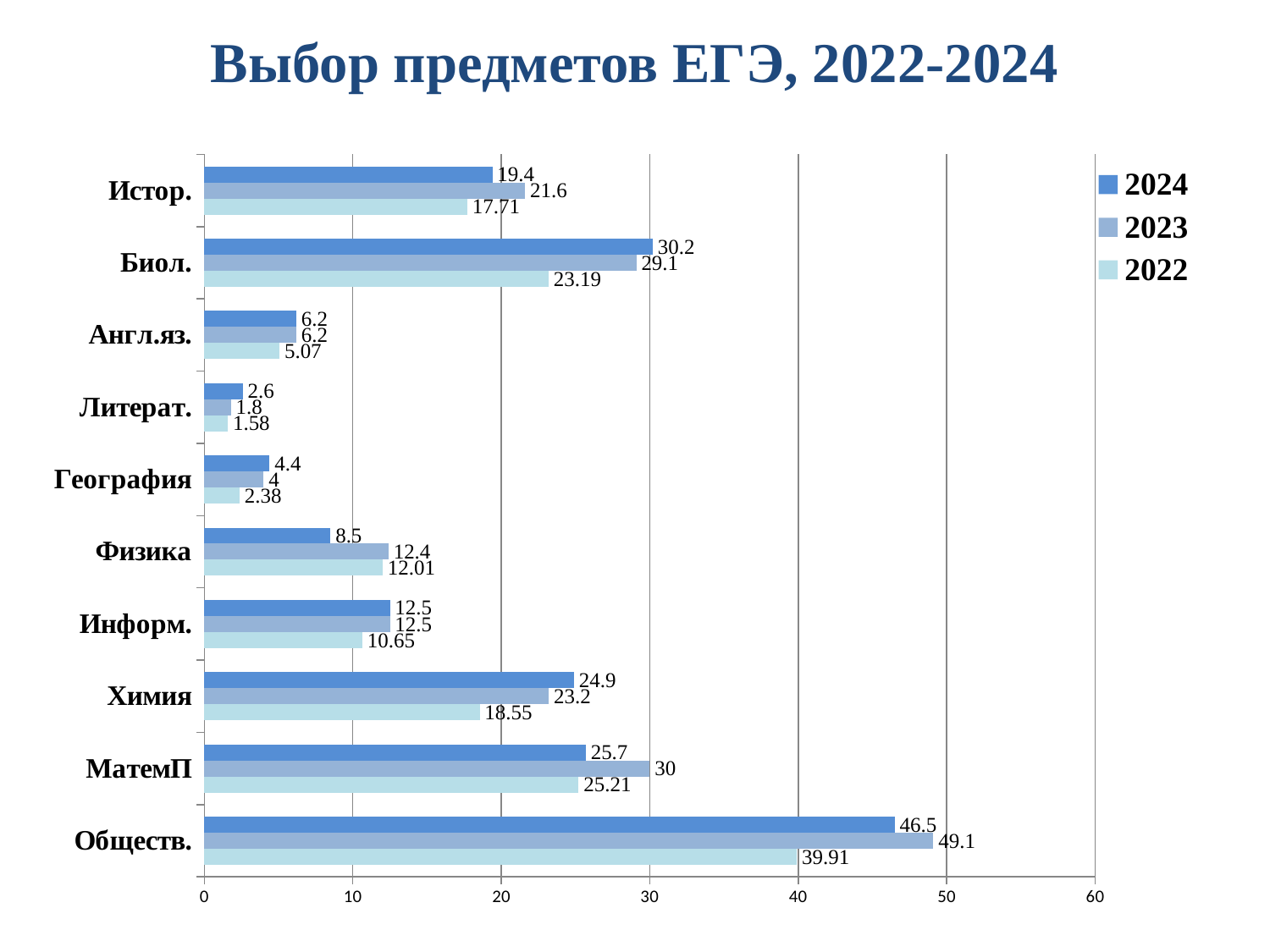
What is the value for МатемП in 2023? 30 Which is larger for Физика: the 2024 value or the 2023 value? 2023 What is the title of the chart? Выбор предметов ЕГЭ, 2022-2024 What is the value for Обществ. in 2024? 46.5 How many series does the legend list? 3 What is the value for Биол. in 2022? 23.19 What is the difference between the 2024 and 2022 values for Химия? 6.35 How many subjects are shown on the chart? 10 What kind of chart is shown on the slide? bar chart Which subject has the highest value in 2023? Обществ. What is the difference between the 2023 and 2024 values for Обществ.? 2.6 Which subject has the lowest value in 2022? Литерат.